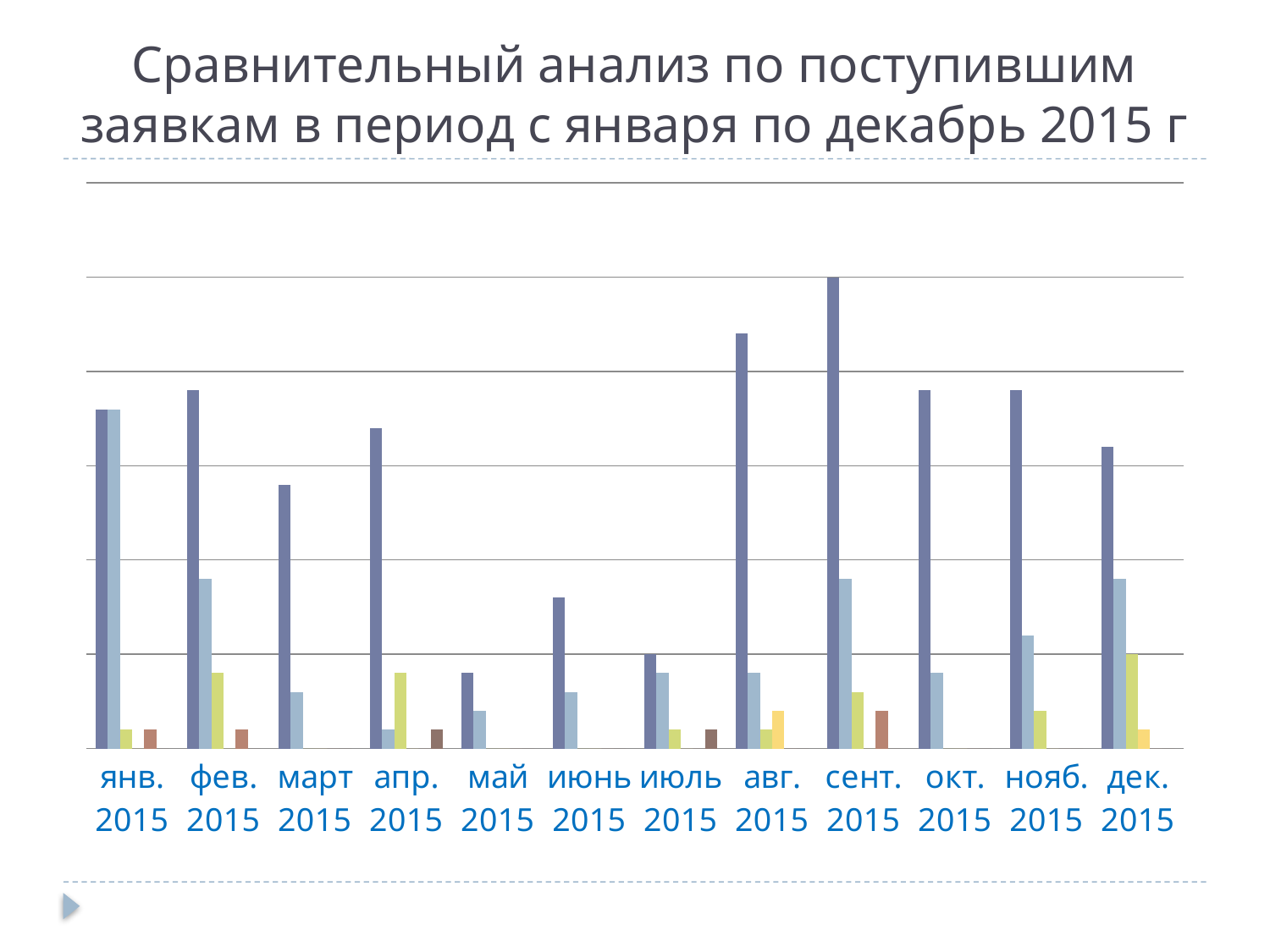
Which month has the taller dark blue bar, авг. 2015 or окт. 2015? авг. 2015 What kind of chart is shown on the slide? bar chart In which month is the dark blue bar the shortest? май 2015 Which month has the taller dark blue bar, март 2015 or апр. 2015? апр. 2015 Do the dark blue bars rise or fall from май 2015 to сент. 2015? rise In which month is the dark blue bar the tallest? сент. 2015 Which month has the taller dark blue bar, июнь 2015 or июль 2015? июнь 2015 How many months (categories) are shown on the x axis? 12 What is the title of the chart on the slide? Сравнительный анализ по поступившим заявкам в период с января по декабрь 2015 г In which month is the yellow-green bar the tallest? дек. 2015 How many months show a brown bar? 5